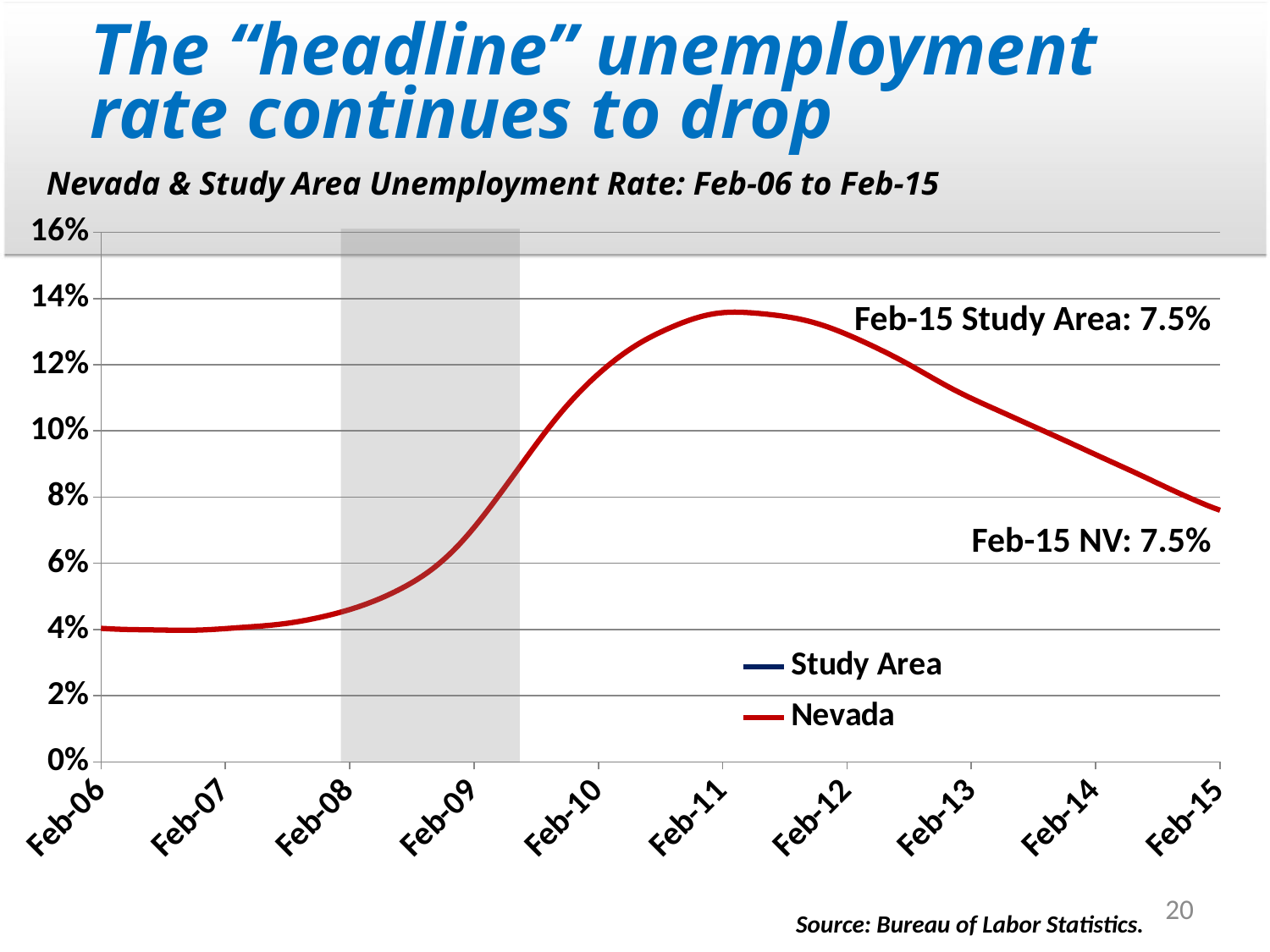
Does the unemployment rate rise or fall from Feb-08 to Feb-11? rise What is the Study Area unemployment rate in Feb-15? 7.5% What kind of chart is shown on the slide? line chart Is the unemployment rate at Feb-11 greater or less than 12%? greater Is the unemployment rate at Feb-06 greater or less than 6%? less At which labeled date on the x axis is the unemployment rate highest? Feb-11 What is the title of the chart? Nevada & Study Area Unemployment Rate: Feb-06 to Feb-15 What is the Nevada (NV) unemployment rate in Feb-15? 7.5% How many date labels are shown on the x axis? 10 Is the unemployment rate at Feb-13 greater or less than 10%? greater How many series does the legend list? 2 Does the unemployment rate rise or fall from Feb-11 to Feb-15? fall